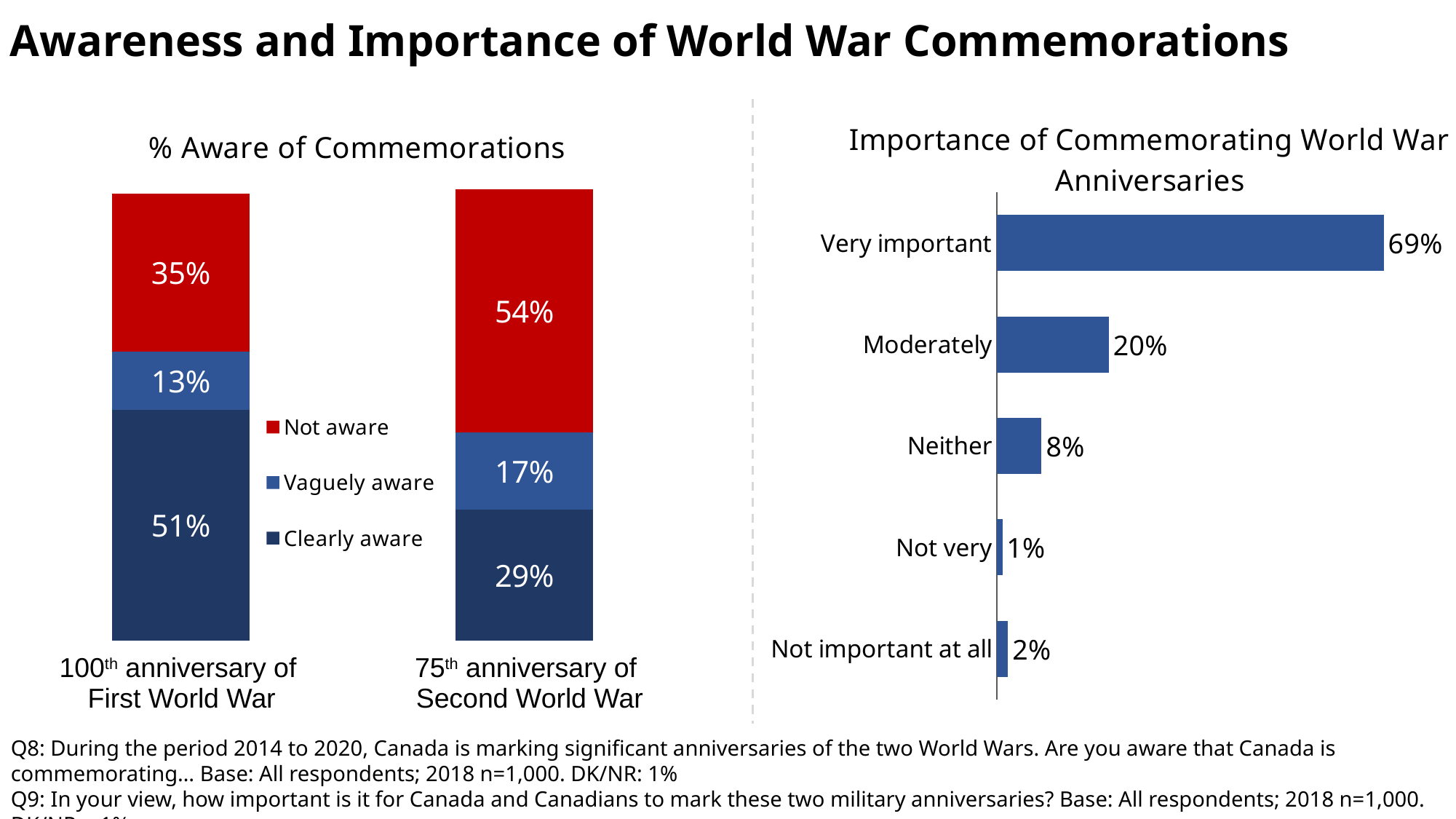
In the '% Aware of Commemorations' chart, which anniversary has the larger 'Clearly aware' share? 100th anniversary of First World War What kind of chart is the 'Importance of Commemorating World War Anniversaries' chart? Bar chart In the 'Importance of Commemorating World War Anniversaries' chart, what is the difference between 'Very important' and 'Moderately'? 49% In the 'Importance of Commemorating World War Anniversaries' chart, what percentage said 'Very important'? 69% In the '% Aware of Commemorations' chart, what percentage is 'Vaguely aware' of the 75th anniversary of Second World War? 17% In the '% Aware of Commemorations' chart, what is the difference between the 'Not aware' values for the Second World War and First World War anniversaries? 19% In the '% Aware of Commemorations' chart, what percentage is 'Clearly aware' of the 100th anniversary of First World War? 51% In the '% Aware of Commemorations' chart, how many series does the legend list? 3 In the '% Aware of Commemorations' chart, what percentage is 'Not aware' of the 75th anniversary of Second World War? 54% In the 'Importance of Commemorating World War Anniversaries' chart, which category has the lowest value? Not very In the '% Aware of Commemorations' chart, what is the total of the stacked bar for the 100th anniversary of First World War? 99% In the 'Importance of Commemorating World War Anniversaries' chart, how many categories are shown? 5